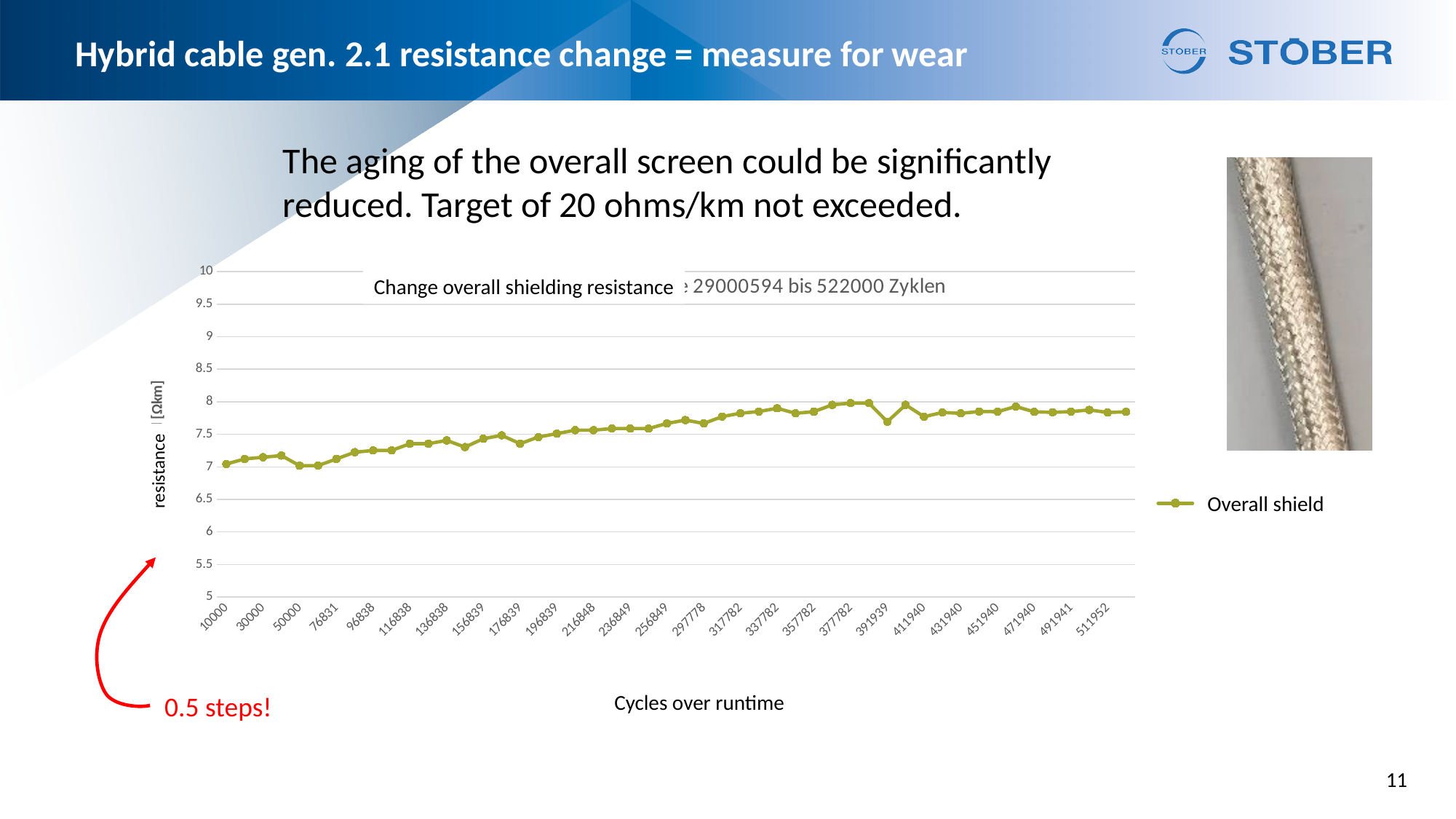
How many series does the chart legend list? 1 Which has the larger resistance value, 30000 cycles or 377782 cycles? 377782 What kind of chart is shown on the slide? line chart What is the name of the series shown in the chart legend? Overall shield Which has the larger resistance value, 10000 cycles or 511952 cycles? 511952 Is the value for 30000 cycles greater or less than 7.5? less Is the value for 297778 cycles greater or less than 7.5? greater Is the value for 10000 cycles greater or less than 7.5? less What is the label of the x axis of the chart? Cycles over runtime Do the resistance values generally rise or fall as the cycles increase along the x axis? rise